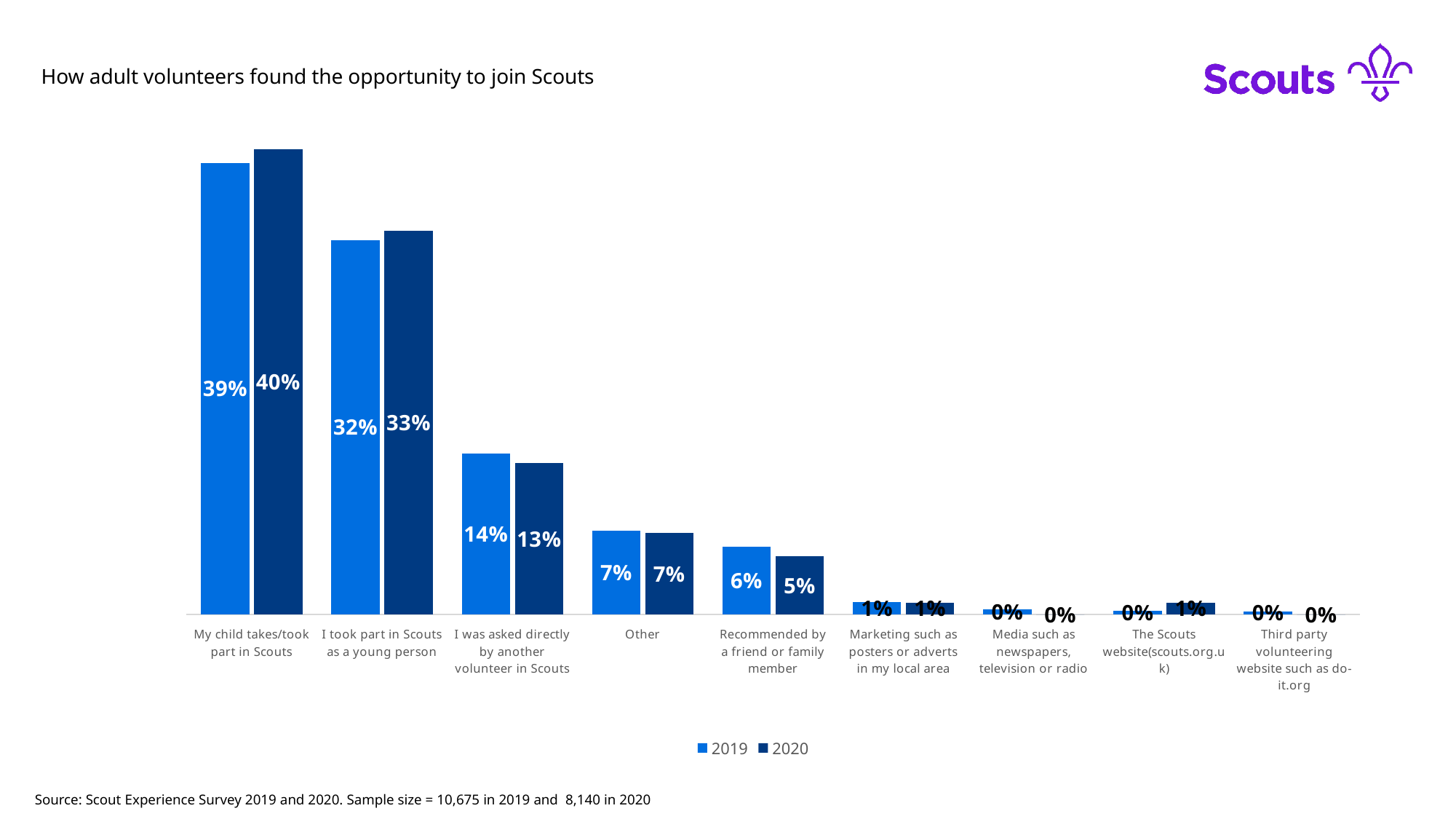
What is the 2019 value for 'I took part in Scouts as a young person'? 32% What is the title of the chart? How adult volunteers found the opportunity to join Scouts What is the 2020 value for 'Recommended by a friend or family member'? 5% Do the 2020 values generally rise or fall moving from left to right along the x axis? Fall How many series does the legend list? 2 What is the difference between the 2019 and 2020 values for 'I was asked directly by another volunteer in Scouts'? 1% Which category has the highest 2019 value? My child takes/took part in Scouts What kind of chart is shown on the slide? Bar chart What is the 2019 value for 'I was asked directly by another volunteer in Scouts'? 14% Which is larger for 'Recommended by a friend or family member': the 2019 value or the 2020 value? 2019 How many categories are shown on the x axis? 9 What is the 2020 value for 'My child takes/took part in Scouts'? 40%